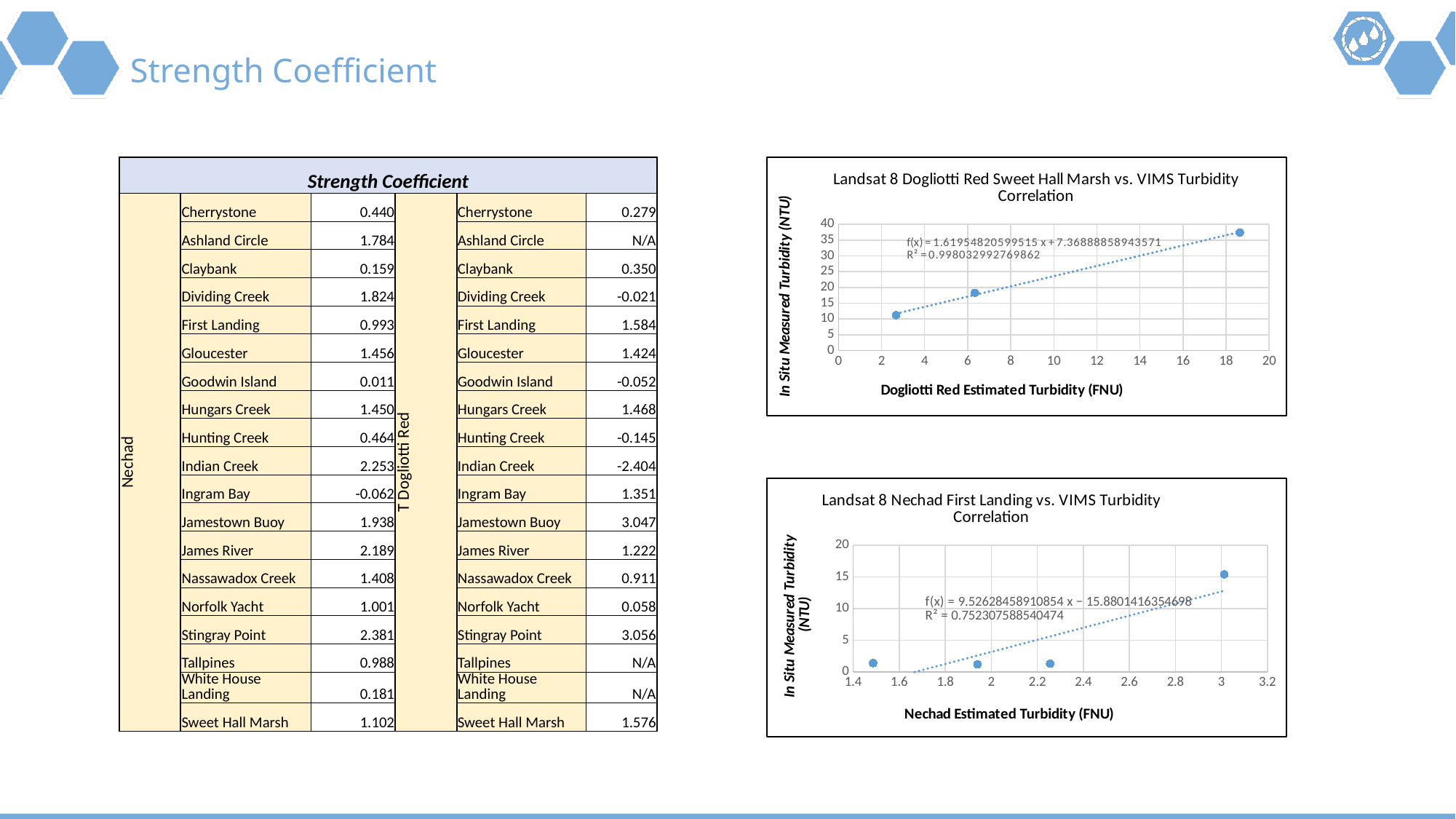
In the 'Landsat 8 Nechad First Landing vs. VIMS Turbidity Correlation' chart, is the in situ measured turbidity of the rightmost point greater or less than 10? greater What is the maximum value shown on the y axis of the 'Landsat 8 Dogliotti Red Sweet Hall Marsh vs. VIMS Turbidity Correlation' chart? 40 In the 'Landsat 8 Dogliotti Red Sweet Hall Marsh vs. VIMS Turbidity Correlation' chart, is the in situ measured turbidity of the rightmost point greater or less than 35? greater In the 'Landsat 8 Nechad First Landing vs. VIMS Turbidity Correlation' chart, is the in situ measured turbidity of the leftmost point greater or less than 5? less What R² value is printed on the 'Landsat 8 Nechad First Landing vs. VIMS Turbidity Correlation' chart? 0.752307588540474 How many data points are plotted in the 'Landsat 8 Nechad First Landing vs. VIMS Turbidity Correlation' chart? 4 In the 'Landsat 8 Nechad First Landing vs. VIMS Turbidity Correlation' chart, which point has the highest in situ measured turbidity: the leftmost or the rightmost? the rightmost How many data points are plotted in the 'Landsat 8 Dogliotti Red Sweet Hall Marsh vs. VIMS Turbidity Correlation' chart? 3 What kind of chart is the 'Landsat 8 Dogliotti Red Sweet Hall Marsh vs. VIMS Turbidity Correlation' chart? scatter chart In the 'Landsat 8 Dogliotti Red Sweet Hall Marsh vs. VIMS Turbidity Correlation' chart, do the in situ measured turbidity values rise or fall as the Dogliotti Red estimated turbidity increases? rise